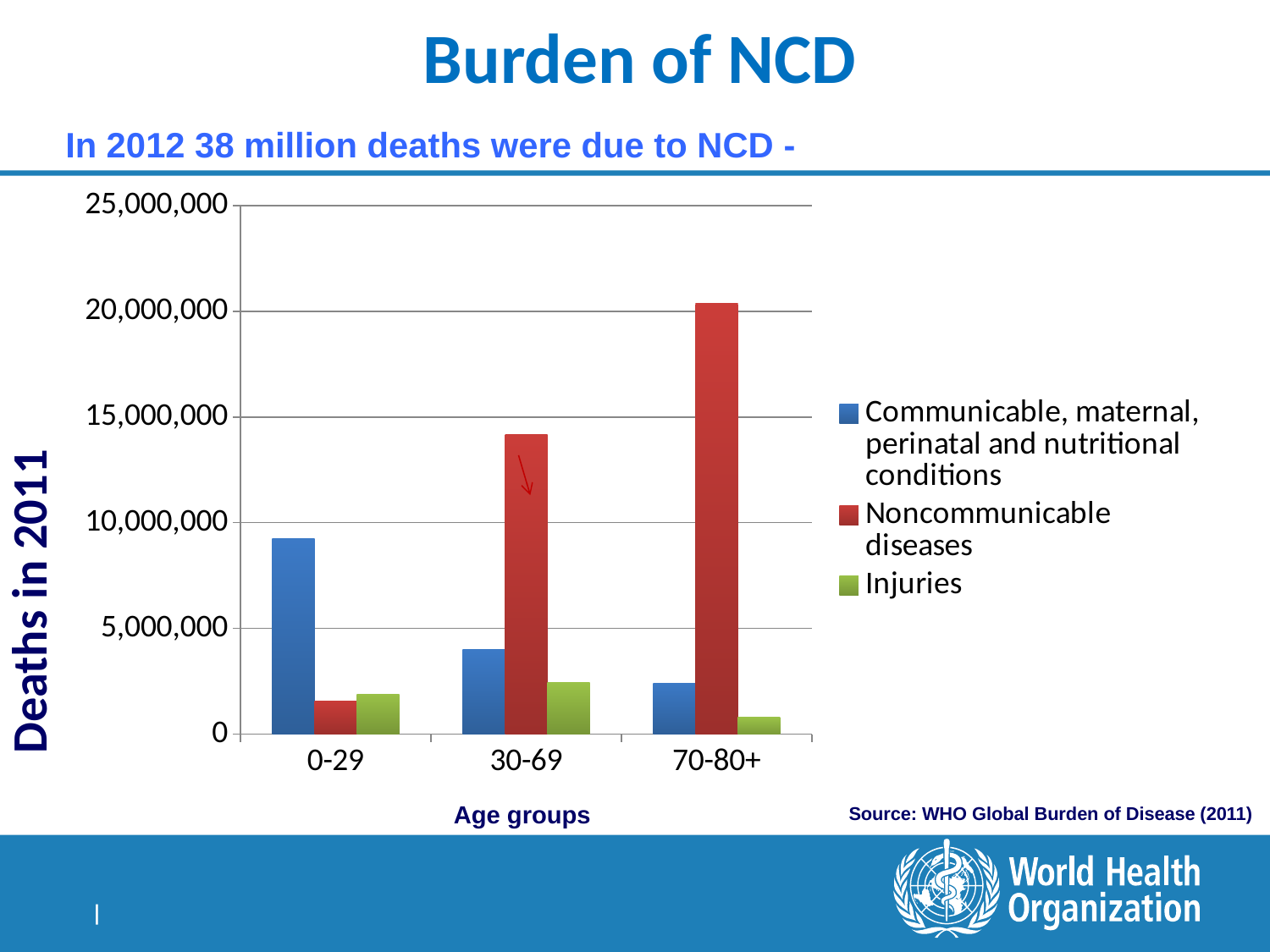
Is the value for communicable, maternal, perinatal and nutritional conditions in the 0-29 age group greater or less than 10,000,000? less Is the value for noncommunicable diseases in the 70-80+ age group greater or less than 15,000,000? greater Is the value for noncommunicable diseases in the 30-69 age group greater or less than 15,000,000? less Which is larger: communicable, maternal, perinatal and nutritional conditions deaths in the 30-69 age group or in the 70-80+ age group? 30-69 What is the title of the vertical axis? Deaths in 2011 In the 70-80+ age group, which cause of death has the lowest bar? Injuries Do deaths from noncommunicable diseases rise or fall as the age groups increase along the x axis? rise In the 0-29 age group, which cause of death has the highest bar? Communicable, maternal, perinatal and nutritional conditions Which age group has the highest number of deaths from noncommunicable diseases? 70-80+ How many series does the legend list? 3 How many age groups are shown on the x axis? 3 What kind of chart is shown on the slide? bar chart